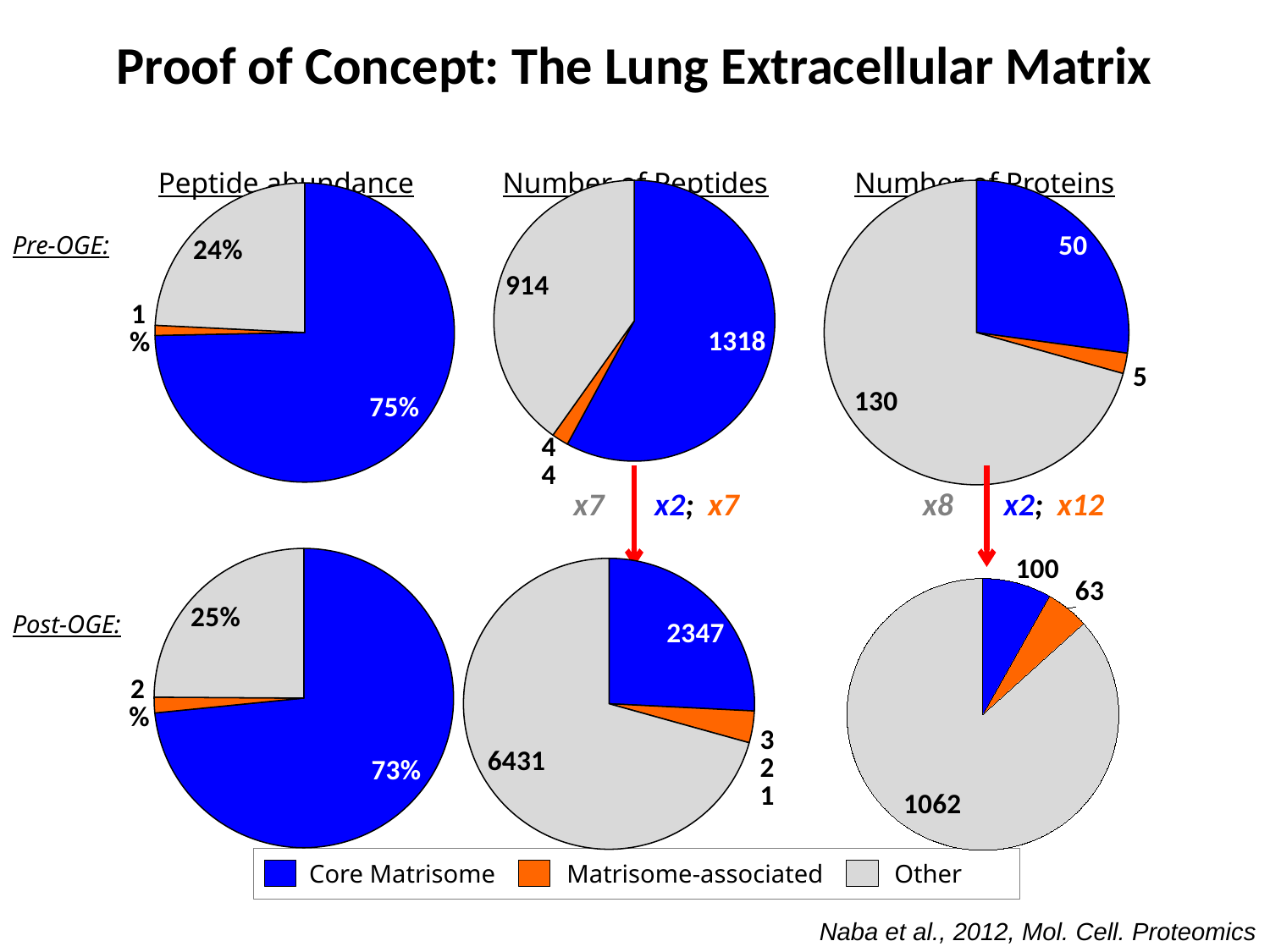
In the Pre-OGE Number of Peptides pie chart, what is the value for Core Matrisome? 1318 In the Post-OGE Number of Proteins pie chart, what is the value for Core Matrisome? 100 In the Pre-OGE Peptide abundance pie chart, what share is Core Matrisome? 75% In the Pre-OGE Peptide abundance pie chart, what share is Other? 24% In the Post-OGE Number of Peptides pie chart, what is the value for Other? 6431 In the Pre-OGE Number of Peptides pie chart, what is the value for Other? 914 In the Post-OGE Peptide abundance pie chart, what share is Matrisome-associated? 2% In the Post-OGE Number of Proteins pie chart, what is the difference between Other and Core Matrisome? 962 In the Pre-OGE Number of Proteins pie chart, which is larger, Other or Core Matrisome? Other What kind of charts are shown on the slide? Pie charts How many categories does the legend list? 3 In the Pre-OGE Number of Proteins pie chart, which category has the lowest value? Matrisome-associated